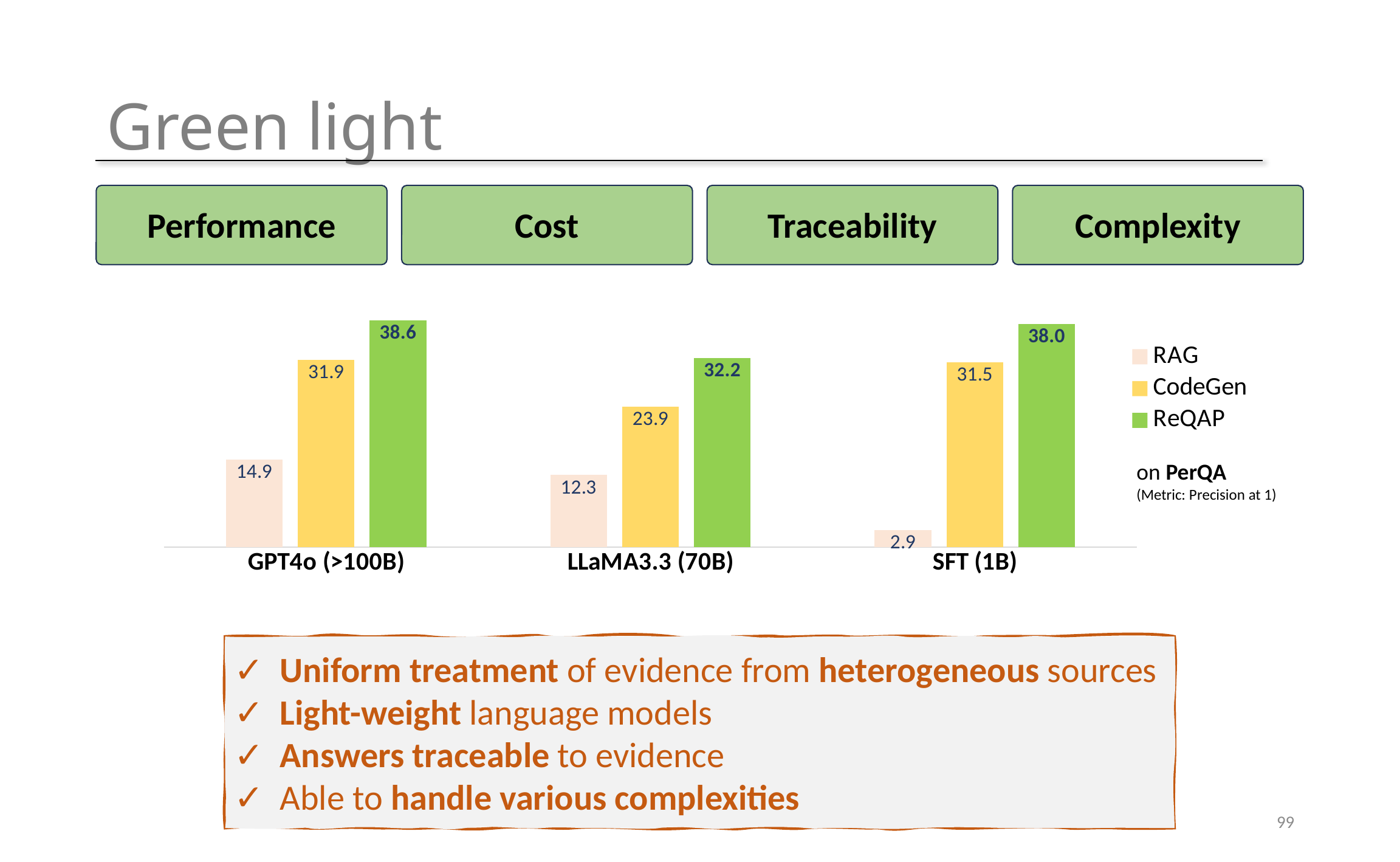
What is the value for RAG on SFT (1B)? 2.9 Which dataset and metric does the chart report, according to the note beside the legend? PerQA, Precision at 1 What is the value for CodeGen on LLaMA3.3 (70B)? 23.9 Which model group has the lowest RAG value? SFT (1B) How many series does the legend list? 3 What is the difference between ReQAP and CodeGen on SFT (1B)? 6.5 How many model groups are shown on the x axis? 3 What is the value for ReQAP on GPT4o (>100B)? 38.6 Which is larger: CodeGen on GPT4o (>100B) or CodeGen on SFT (1B)? CodeGen on GPT4o (>100B) What kind of chart is shown on the slide? Bar chart What is the difference between ReQAP and RAG on GPT4o (>100B)? 23.7 Which series has the highest value on LLaMA3.3 (70B)? ReQAP